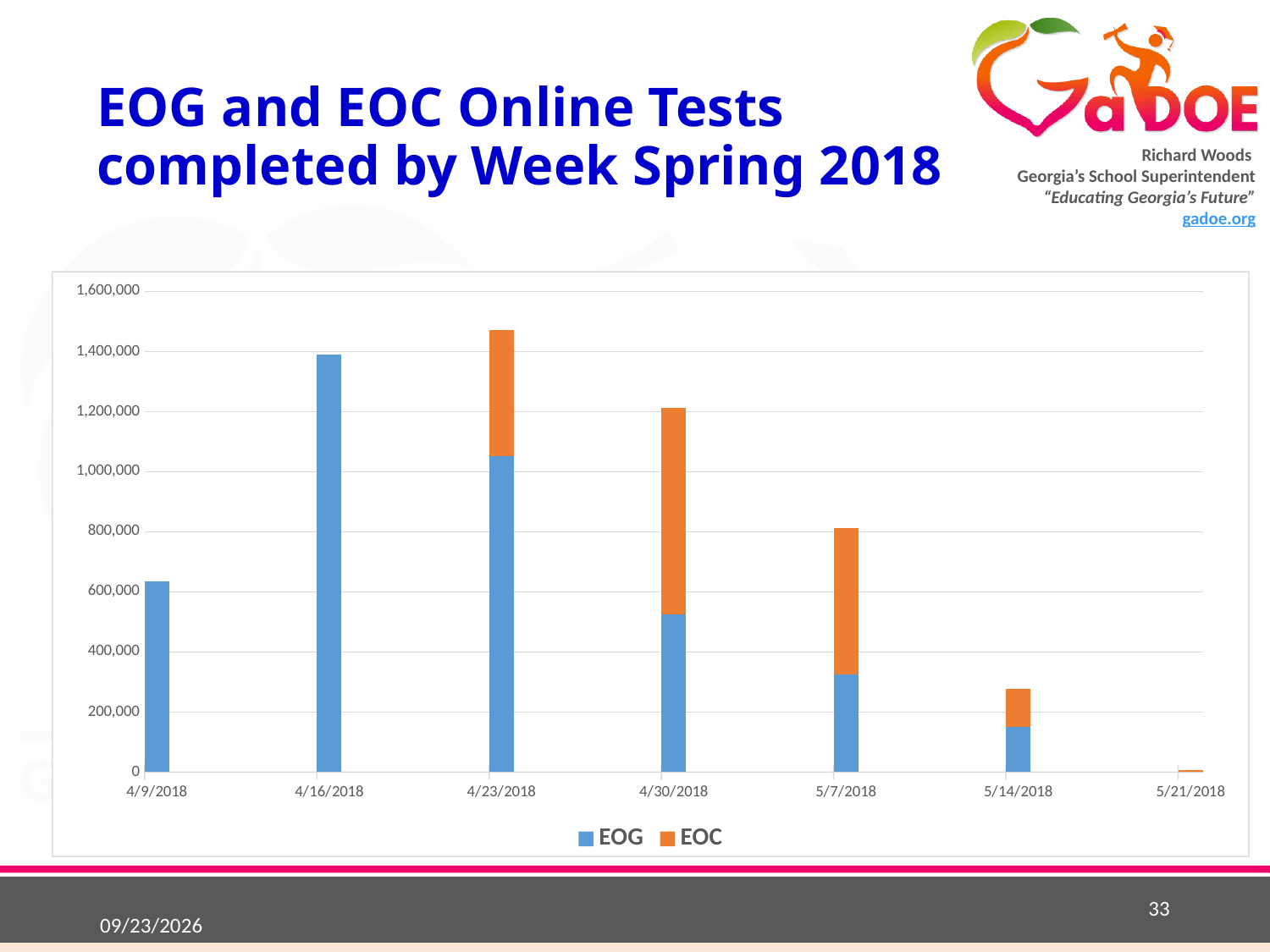
What kind of chart is shown on the slide? Stacked bar chart Which week has the smallest total stacked bar? 5/21/2018 How many week dates are shown on the x axis? 7 Which week has the tallest EOC bar segment? 4/30/2018 Which week has the tallest EOG bar segment? 4/16/2018 Which is larger, the EOG value for 4/16/2018 or the EOG value for 4/23/2018? 4/16/2018 How many series does the legend list? 2 Do the total stacked bars rise or fall from 4/23/2018 to 5/21/2018? fall Which week has the tallest total stacked bar? 4/23/2018 Is the EOG value for 4/16/2018 greater or less than 1,200,000? greater Is the total stacked bar for 4/30/2018 greater or less than 1,000,000? greater Is the total stacked bar for 5/14/2018 greater or less than 400,000? less